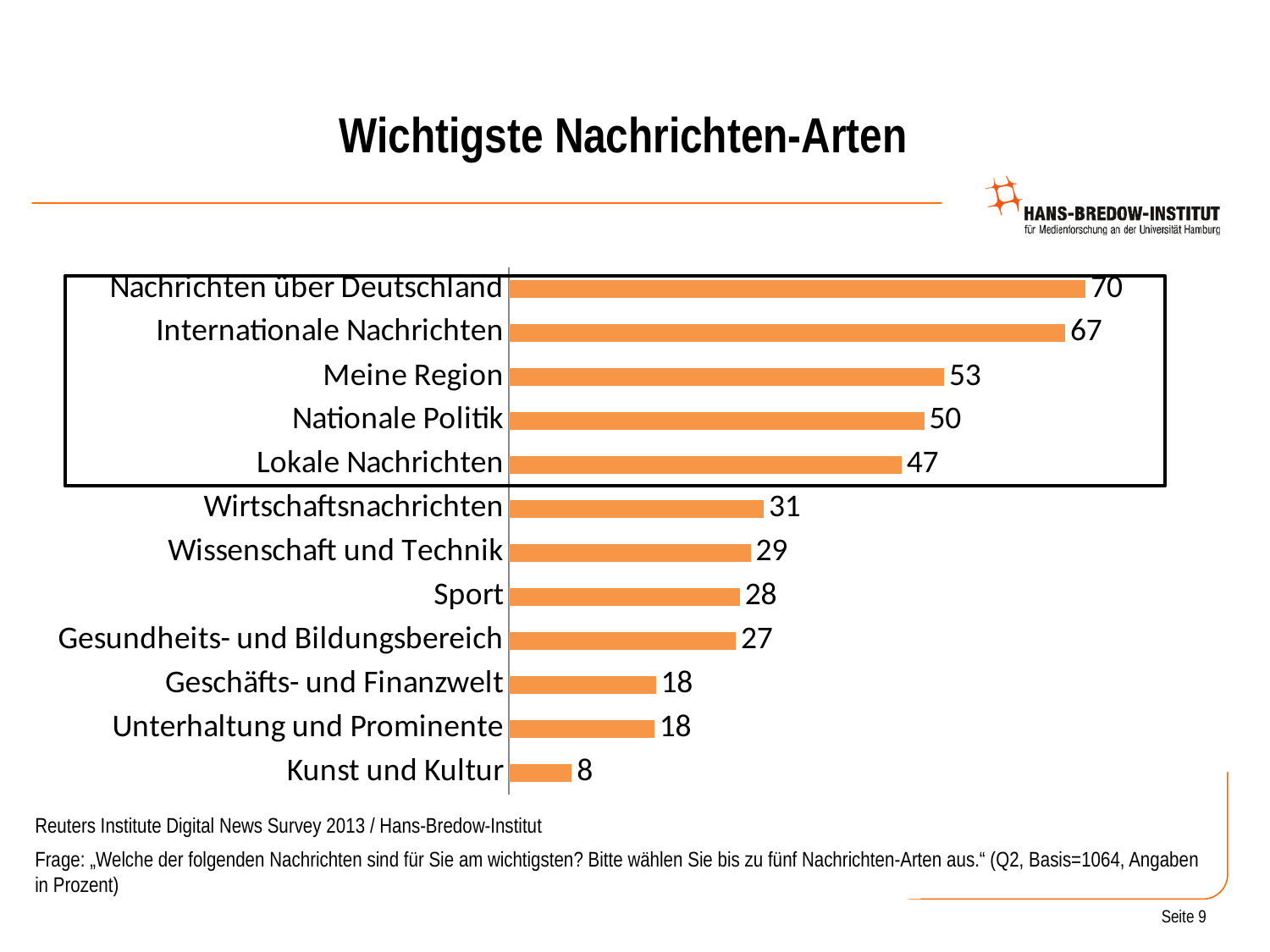
What is the value for Nachrichten über Deutschland? 70 Which category has the lowest value? Kunst und Kultur What is the title of the slide? Wichtigste Nachrichten-Arten What is the difference between the values for Wirtschaftsnachrichten and Kunst und Kultur? 23 Which category has the highest value? Nachrichten über Deutschland Which is larger, the value for Nationale Politik or the value for Wissenschaft und Technik? Nationale Politik What is the value for Sport? 28 What is the value for Meine Region? 53 Which two categories share the value 18? Geschäfts- und Finanzwelt and Unterhaltung und Prominente What kind of chart is shown on the slide? Bar chart How many categories are shown in the chart? 12 What is the difference between the values for Internationale Nachrichten and Lokale Nachrichten? 20